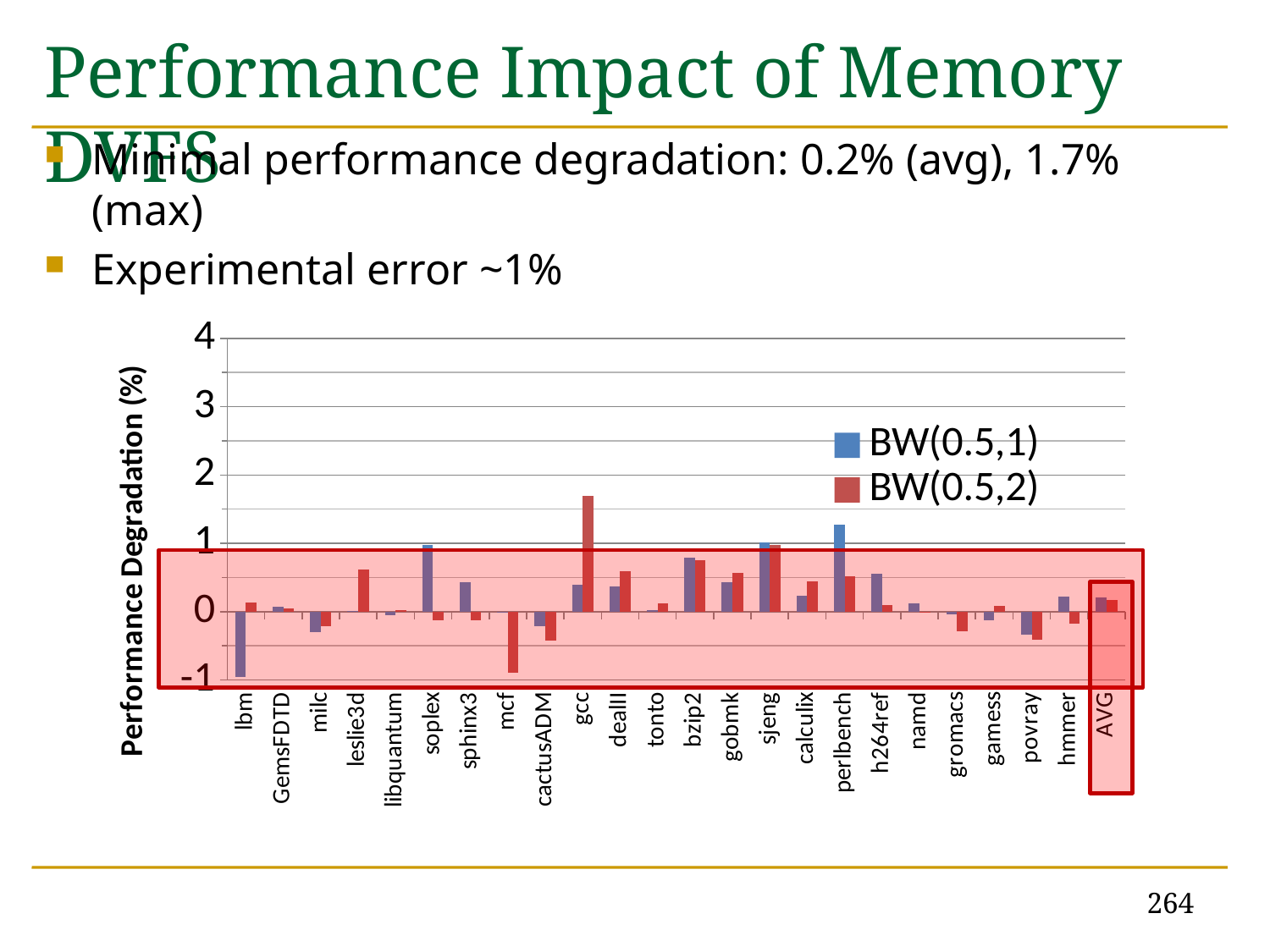
What kind of chart is shown on the slide? bar chart Which category has the highest bar in the chart? gcc What is the label of the chart's vertical axis? Performance Degradation (%) Is the BW(0.5,1) value for perlbench greater or less than 1? greater Is the BW(0.5,2) value for gcc greater or less than 1? greater Is the BW(0.5,2) value for mcf greater or less than 0? less How many series does the chart's legend list? 2 Which is larger: the BW(0.5,2) value for gcc or the BW(0.5,2) value for dealII? gcc Which is larger: the BW(0.5,2) value for gcc or the BW(0.5,1) value for perlbench? gcc BW(0.5,2) What are the two series named in the chart's legend? BW(0.5,1) and BW(0.5,2) How many categories are shown along the x axis of the chart, including AVG? 24